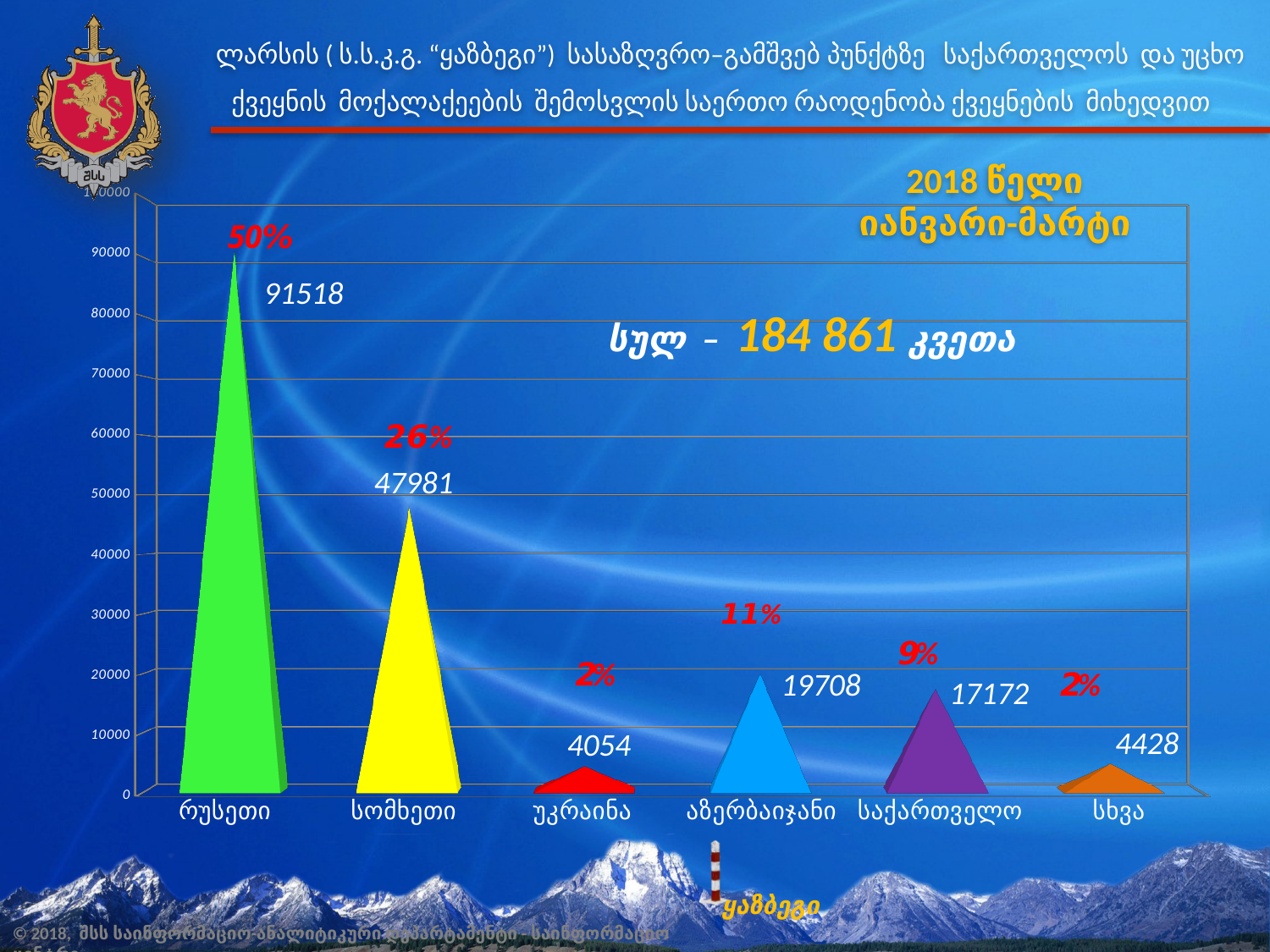
Which category has the lowest value? უკრაინა What is the difference between the values for რუსეთი (Russia) and სომხეთი (Armenia)? 43537 What is the value shown for აზერბაიჯანი (Azerbaijan)? 19708 Is the value for სომხეთი (Armenia) greater or less than 40000? greater What percentage label is shown above the bar for სომხეთი (Armenia)? 26% Which is larger, the value for აზერბაიჯანი (Azerbaijan) or საქართველო (Georgia)? აზერბაიჯანი Which category has the highest value? რუსეთი What is the value shown for რუსეთი (Russia)? 91518 What is the value shown for საქართველო (Georgia)? 17172 What total (სულ) is stated on the slide? 184 861 How many categories are shown on the x axis? 6 What is the value shown for სომხეთი (Armenia)? 47981